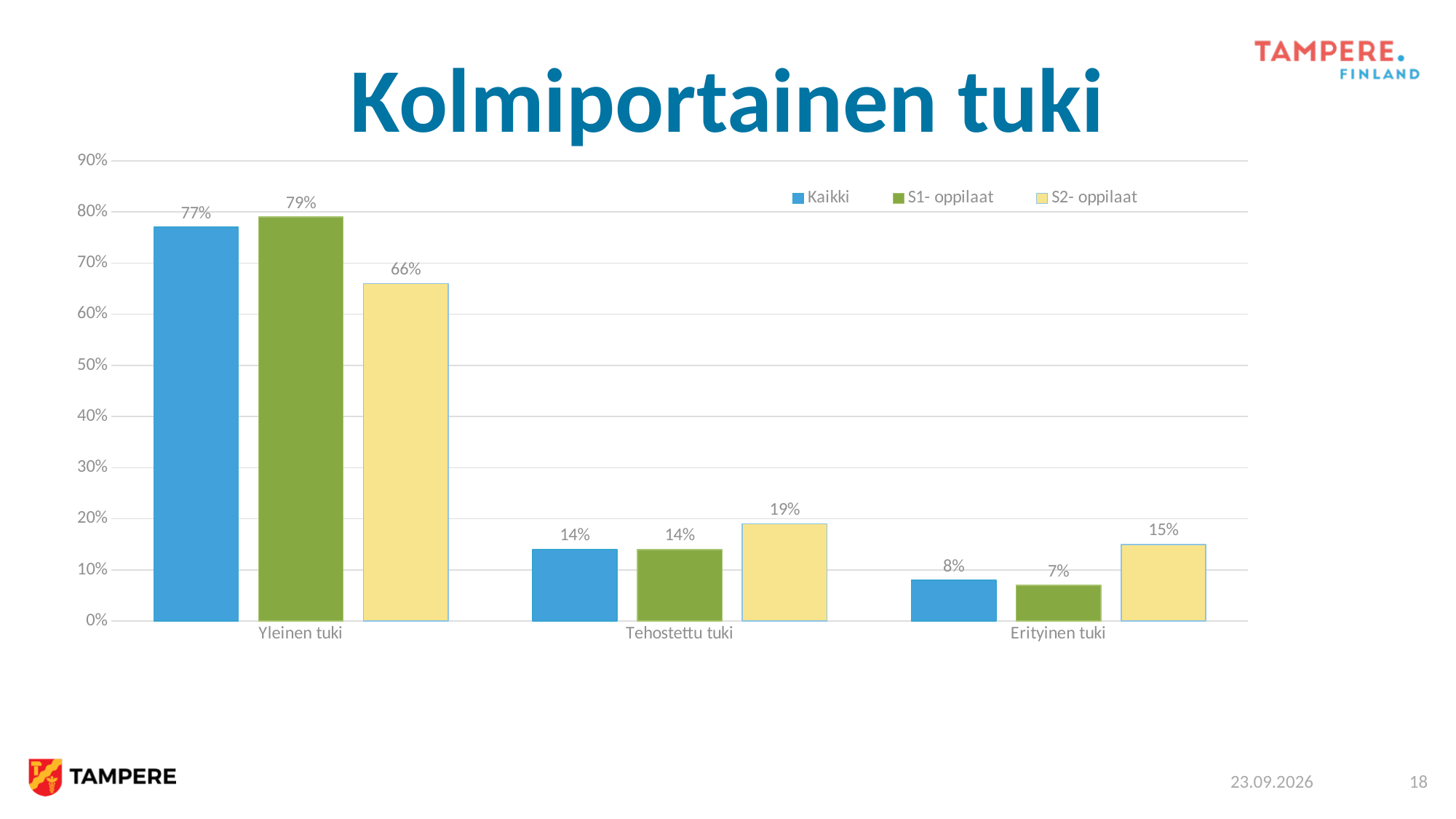
What is the title of the chart? Kolmiportainen tuki What is the value for Kaikki in the Yleinen tuki category? 77% What is the value for S2- oppilaat in the Tehostettu tuki category? 19% Which category has the lowest value for the Kaikki series? Erityinen tuki Is the value for S2- oppilaat in Yleinen tuki greater or less than 70%? less Which series has the highest value in the Yleinen tuki category? S1- oppilaat What kind of chart is shown on the slide? Bar chart What is the value for S1- oppilaat in the Erityinen tuki category? 7% How many categories are shown on the x axis? 3 What is the difference between the S1- oppilaat and S2- oppilaat values in the Yleinen tuki category? 13% How many series does the legend list? 3 Which is larger in the Erityinen tuki category: the Kaikki value or the S2- oppilaat value? S2- oppilaat